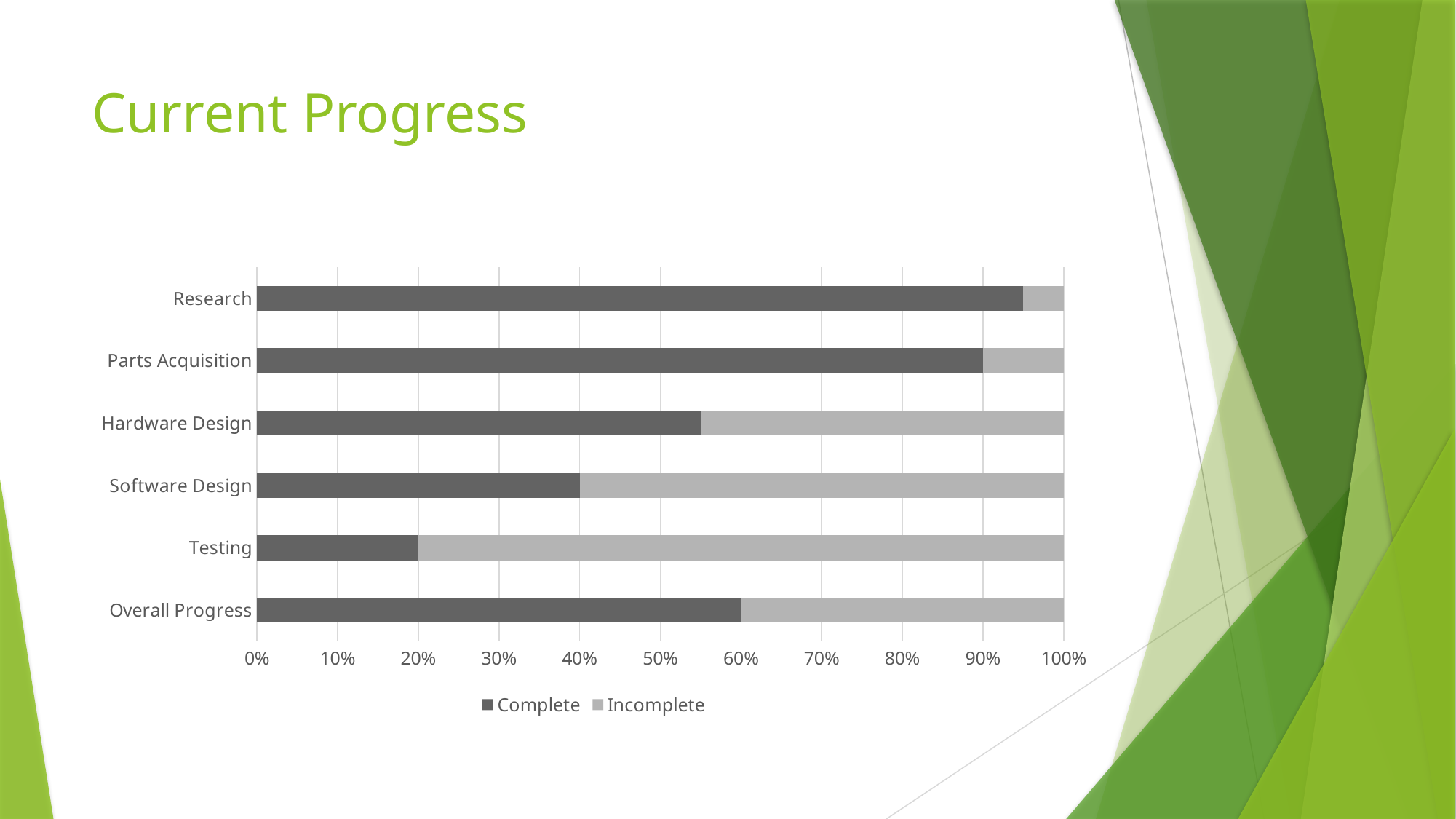
What is the Complete value for Testing? 20% Which category has the lowest Complete value? Testing Is the Complete value for Hardware Design greater or less than 50%? greater Which is larger, the Complete value for Software Design or for Overall Progress? Overall Progress What is the Complete value for Parts Acquisition? 90% What is the Complete value for Overall Progress? 60% How many series does the legend list? 2 What is the Complete value for Software Design? 40% Is the Complete value for Research greater or less than 90%? greater What kind of chart is shown on the slide? bar chart How many categories are shown on the chart? 6 Which category has the highest Complete value? Research